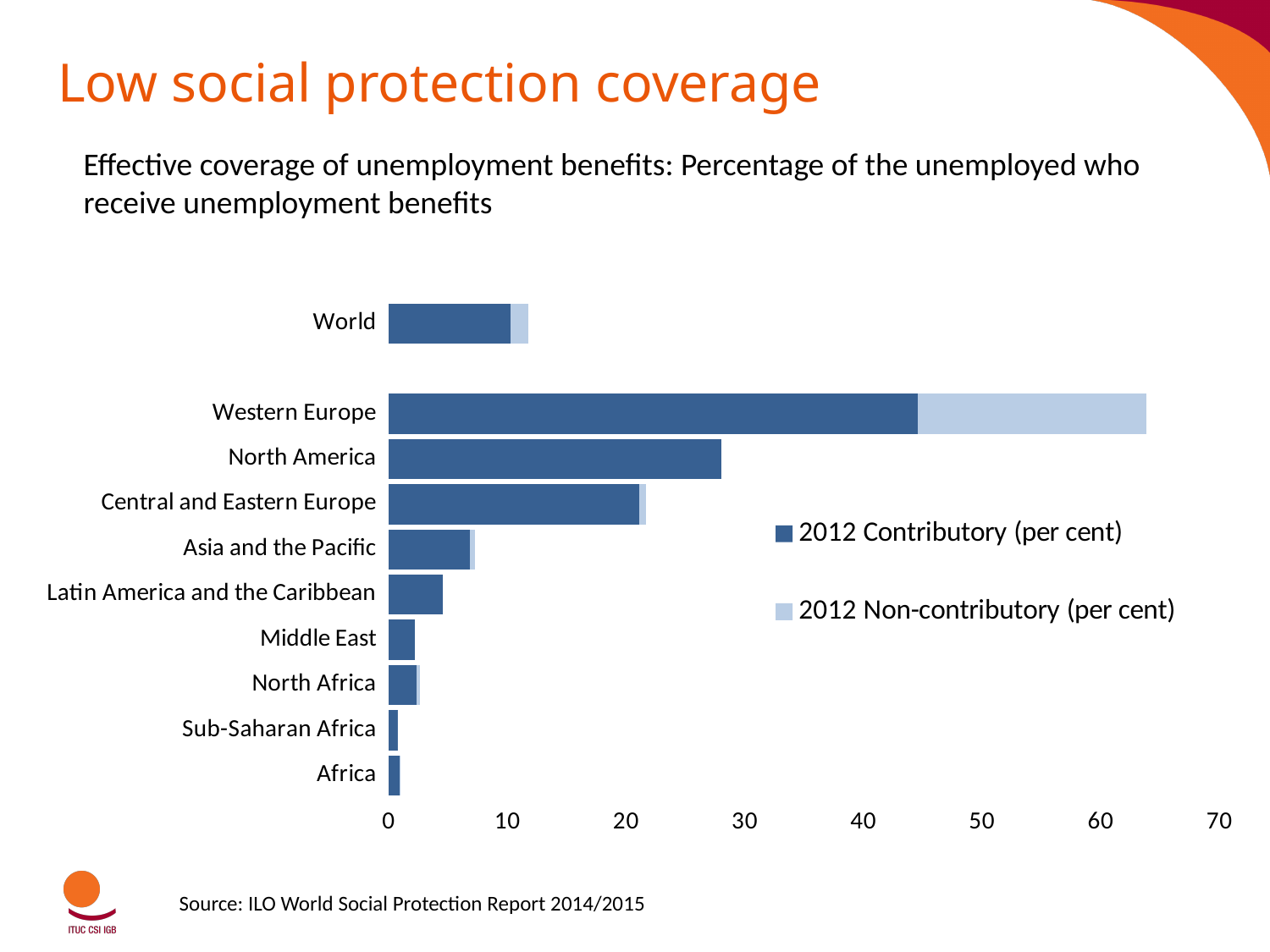
Which has the larger total bar, Asia and the Pacific or Latin America and the Caribbean? Asia and the Pacific Is the total value for World greater or less than 20? less Is the total value for North America greater or less than 30? less What kind of chart is shown on the slide? bar chart How many series does the legend list? 2 Which has the larger total bar, Western Europe or North America? Western Europe Is the total value for Central and Eastern Europe greater or less than 10? greater Which region has the highest total effective coverage of unemployment benefits? Western Europe How many regions (categories) are plotted on the chart? 10 Which has the larger total bar, North America or Central and Eastern Europe? North America What are the two series named in the legend? 2012 Contributory (per cent) and 2012 Non-contributory (per cent)